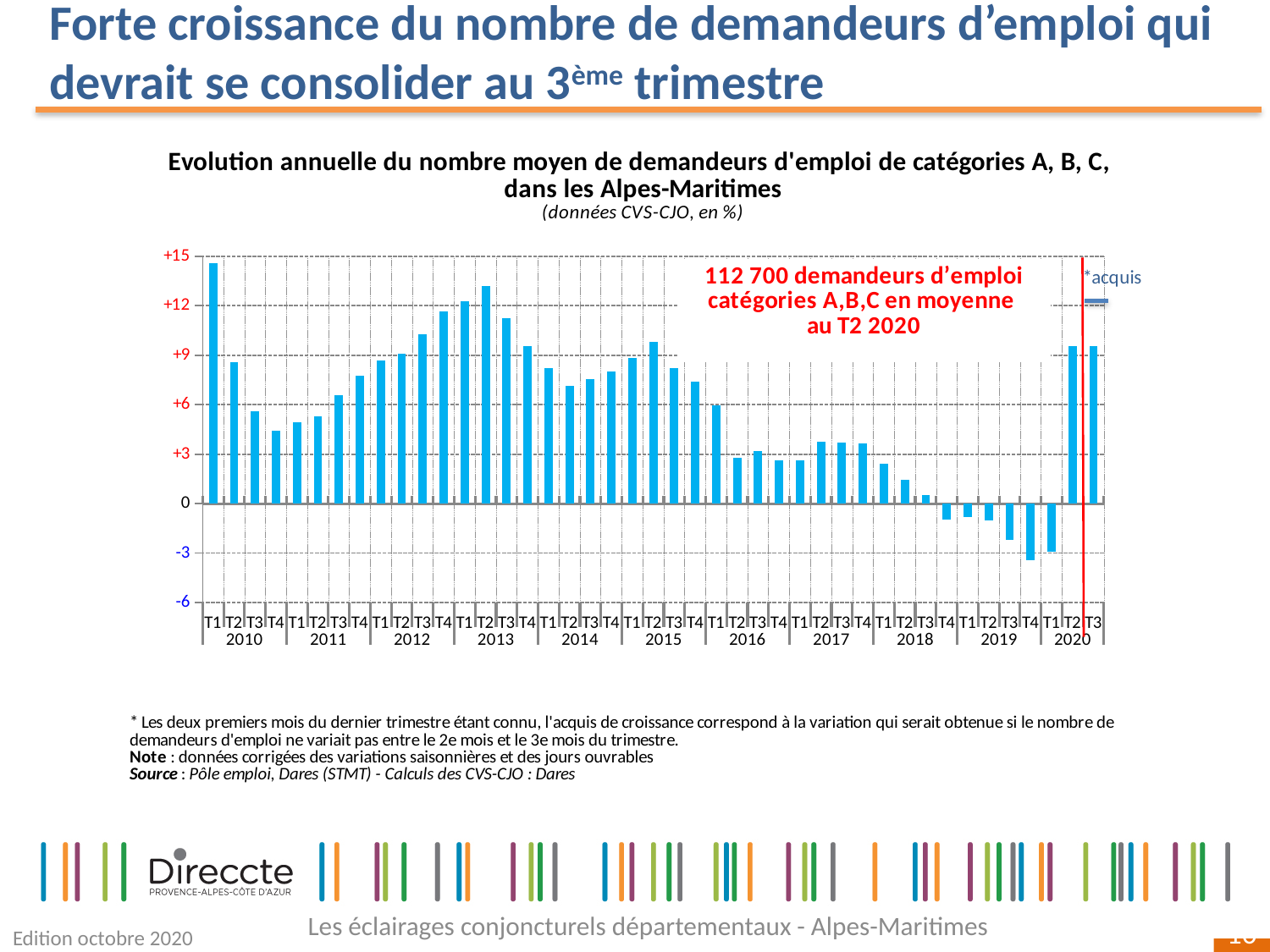
What kind of chart is shown on the slide? bar chart Do the values generally rise or fall from T1 2013 to T4 2019? fall Which quarter has the lowest value in the chart? T4 2019 How many quarterly bars are plotted in the chart? 43 Is the value for T1 2010 greater or less than +12? greater Which is larger, the value for T1 2010 or the value for T1 2013? T1 2010 Is the value for T2 2020 greater or less than +6? greater According to the annotation on the chart, how many demandeurs d'emploi catégories A,B,C were there on average in T2 2020? 112 700 Is the value for T4 2019 greater or less than 0? less Which is larger, the value for T2 2020 or the value for T2 2019? T2 2020 Which quarter has the highest value in the chart? T1 2010